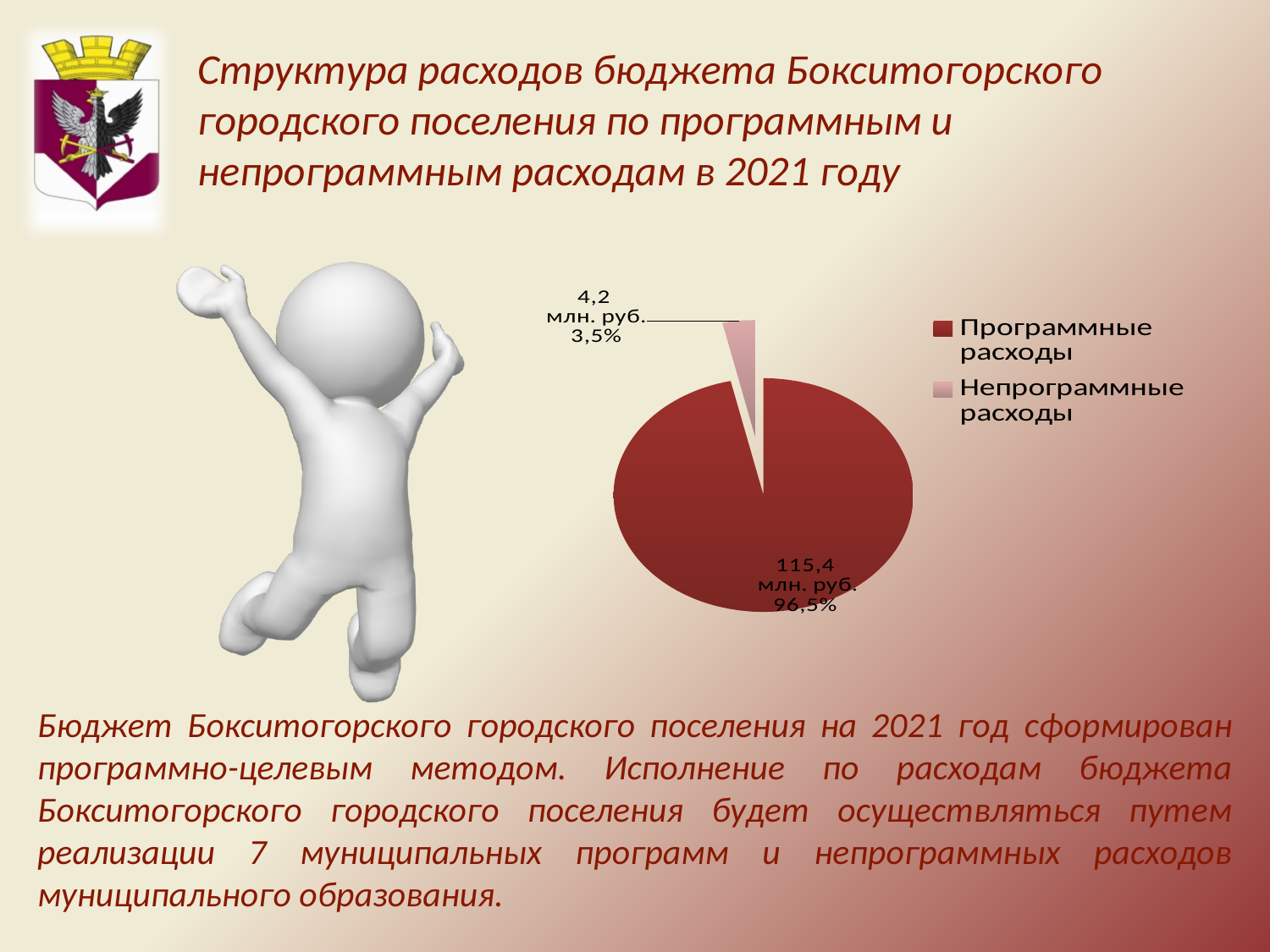
Which is larger, Программные расходы or Непрограммные расходы? Программные расходы What share of the pie does Программные расходы take? 96,5% How many slices does the pie chart have? 2 Which colour represents Непрограммные расходы in the pie chart? light pink What share of the pie does Непрограммные расходы take? 3,5% What is the difference in млн. руб. between Программные расходы and Непрограммные расходы? 111,2 млн. руб. Which slice of the pie chart is the largest? Программные расходы How many series does the legend list? 2 Which slice of the pie chart is the smallest? Непрограммные расходы What kind of chart is shown on the slide? pie chart What is the value for Программные расходы in the pie chart? 115,4 млн. руб. What is the value for Непрограммные расходы in the pie chart? 4,2 млн. руб.